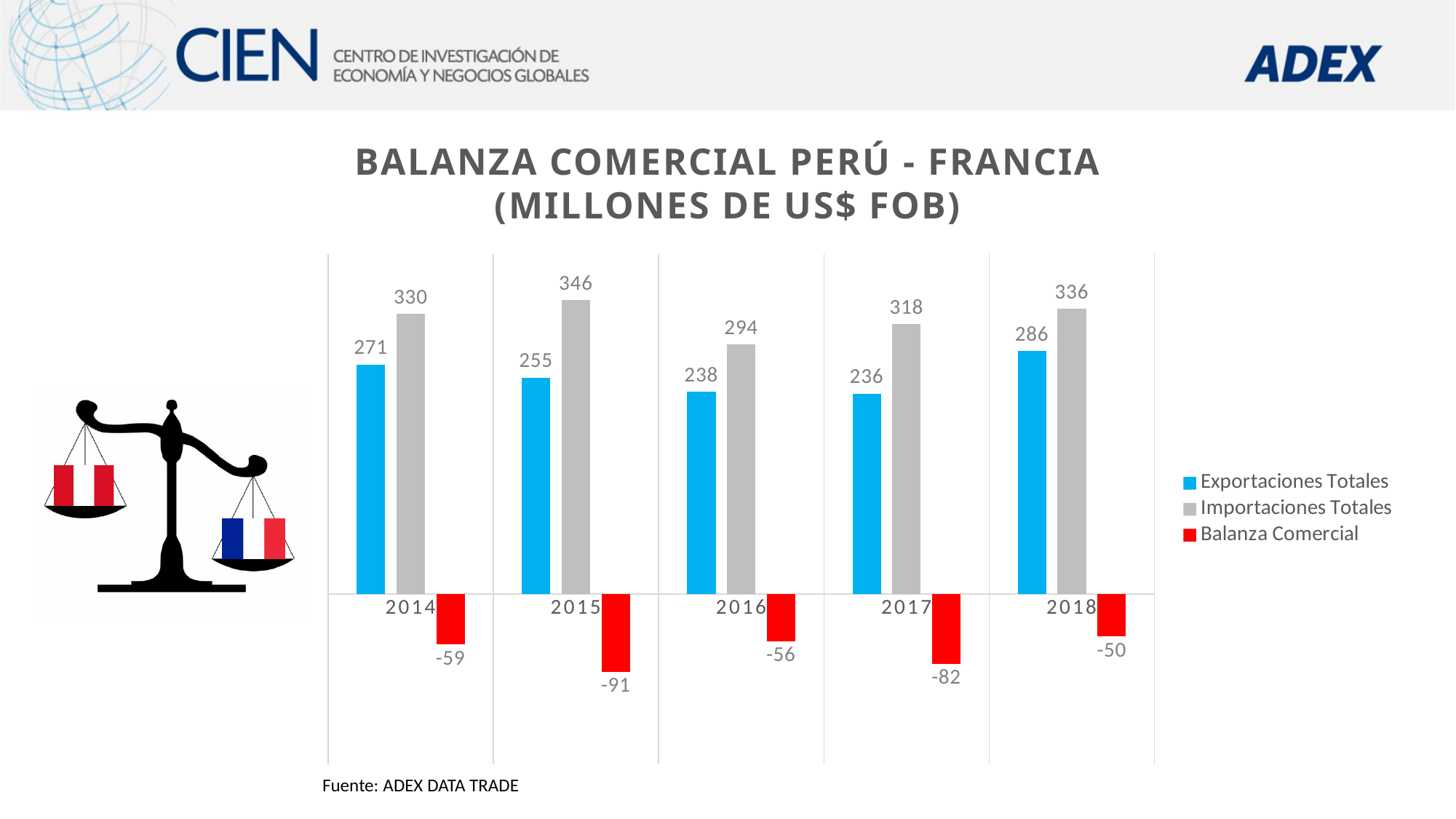
Which is larger in 2016, Exportaciones Totales or Importaciones Totales? Importaciones Totales How many years are shown on the x axis? 5 What is the value of Exportaciones Totales in 2018? 286 In which year is Importaciones Totales highest? 2015 What is the difference between Importaciones Totales and Exportaciones Totales in 2014? 59 What kind of chart is shown on the slide? Bar chart What is the Balanza Comercial value for 2017? -82 What colour are the Balanza Comercial bars? Red Does Exportaciones Totales rise or fall from 2014 to 2017? Fall What is the value of Importaciones Totales in 2015? 346 How many series does the legend list? 3 In which year is Exportaciones Totales lowest? 2017